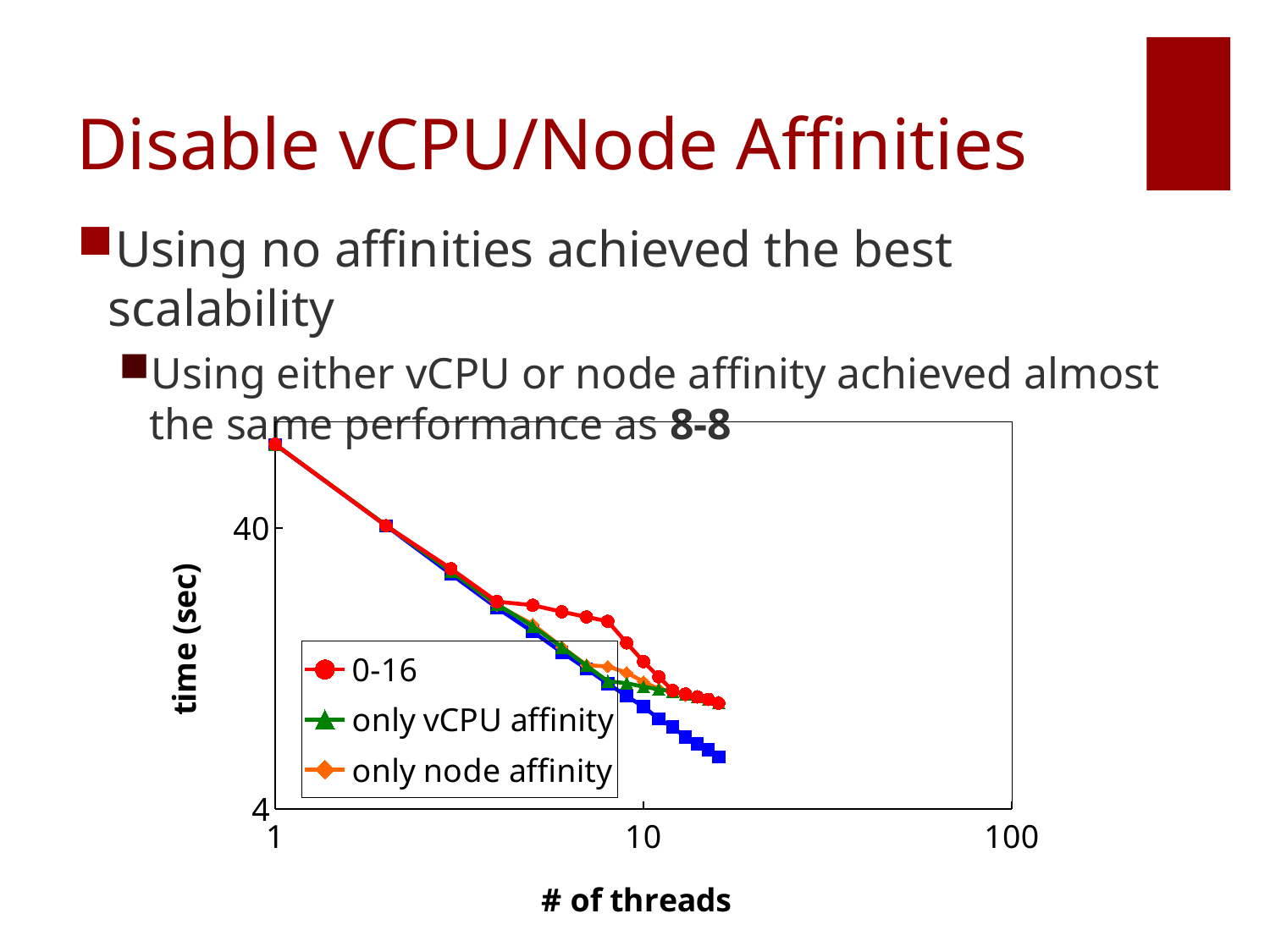
Which legend series has the highest time at 8 threads? 0-16 What kind of chart is shown on the slide? line chart Is the time for the 0-16 series at 4 threads greater or less than 40? less How many series does the chart's legend list? 3 Does the time for the 0-16 series rise or fall as the number of threads increases? fall What is the label of the y axis of the chart? time (sec) Is the time for the only vCPU affinity series at 10 threads greater or less than 4? greater Is the time for the 0-16 series at 1 thread greater or less than 40? greater At 8 threads, which has the higher time: 0-16 or only vCPU affinity? 0-16 Does the time for the only node affinity series rise or fall from 1 thread to 4 threads? fall What is the label of the x axis of the chart? # of threads